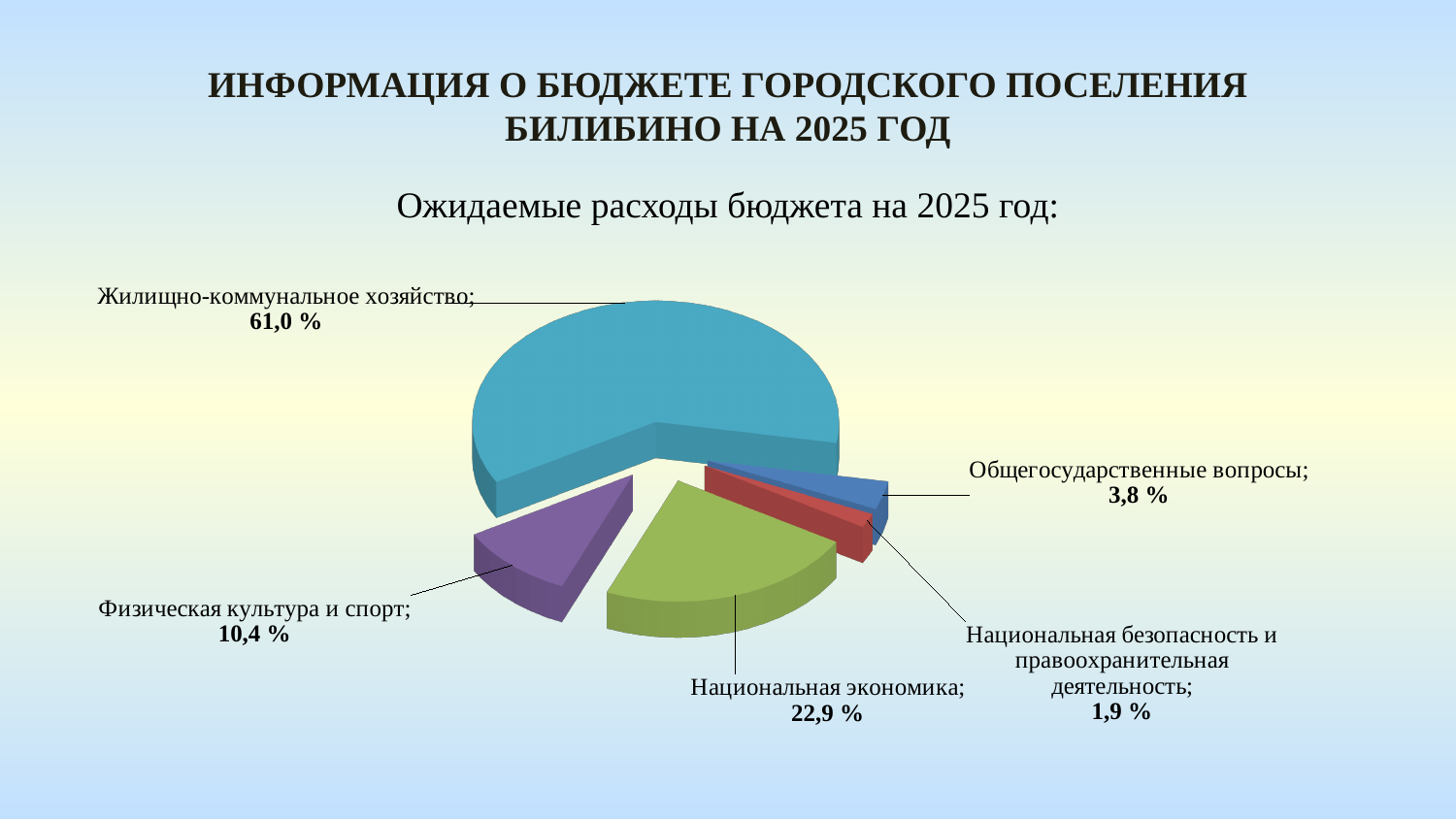
Which category has the largest share of expected 2025 budget expenditures? Жилищно-коммунальное хозяйство What share of expected 2025 budget expenditures goes to Национальная экономика? 22,9 % What share of expected 2025 budget expenditures goes to Национальная безопасность и правоохранительная деятельность? 1,9 % What share of expected 2025 budget expenditures goes to Жилищно-коммунальное хозяйство? 61,0 % What share of expected 2025 budget expenditures goes to Общегосударственные вопросы? 3,8 % How many categories are shown in the pie chart? 5 What is the difference in percentage points between Жилищно-коммунальное хозяйство and Национальная экономика? 38,1 What is the subtitle above the pie chart? Ожидаемые расходы бюджета на 2025 год: Which is larger: the share for Физическая культура и спорт or the share for Общегосударственные вопросы? Физическая культура и спорт Which category has the smallest share of expected 2025 budget expenditures? Национальная безопасность и правоохранительная деятельность What share of expected 2025 budget expenditures goes to Физическая культура и спорт? 10,4 % What type of chart is shown on the slide? Pie chart